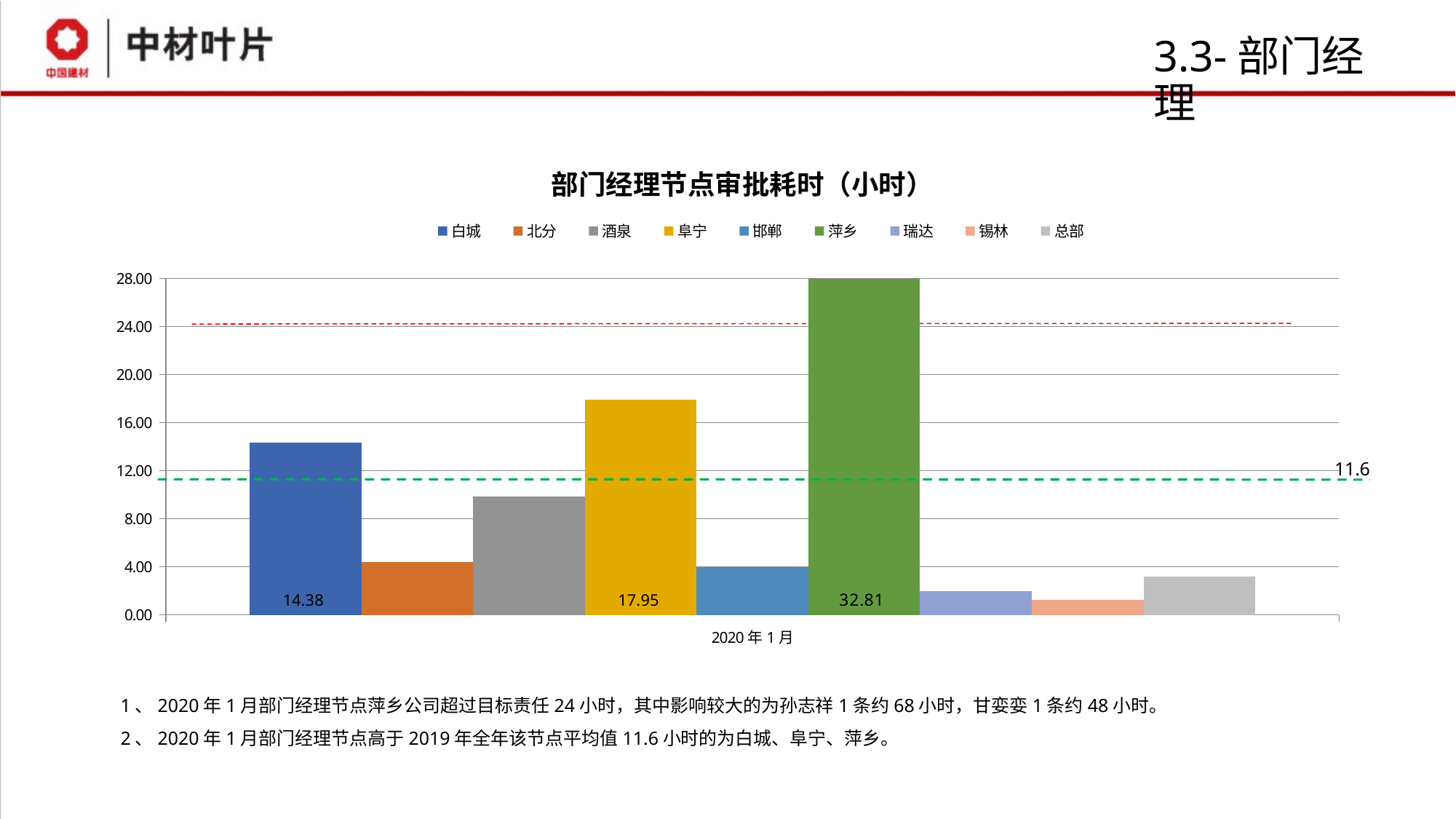
Which series has the highest value in the chart? 萍乡 Is the value for 总部 greater or less than 4.00? less What is the value for 阜宁 in the chart? 17.95 Which is larger, the value for 白城 or the value for 阜宁? 阜宁 What type of chart is shown on the slide? bar chart What is the value for 白城 in the 部门经理节点审批耗时（小时） chart? 14.38 Which series has the lowest value in the chart? 锡林 Is the value for 酒泉 greater or less than 12.00? less What is the difference between the values for 萍乡 and 阜宁? 14.86 What is the difference between the values for 阜宁 and 白城? 3.57 What is the value for 萍乡 in the chart? 32.81 How many series does the legend list? 9